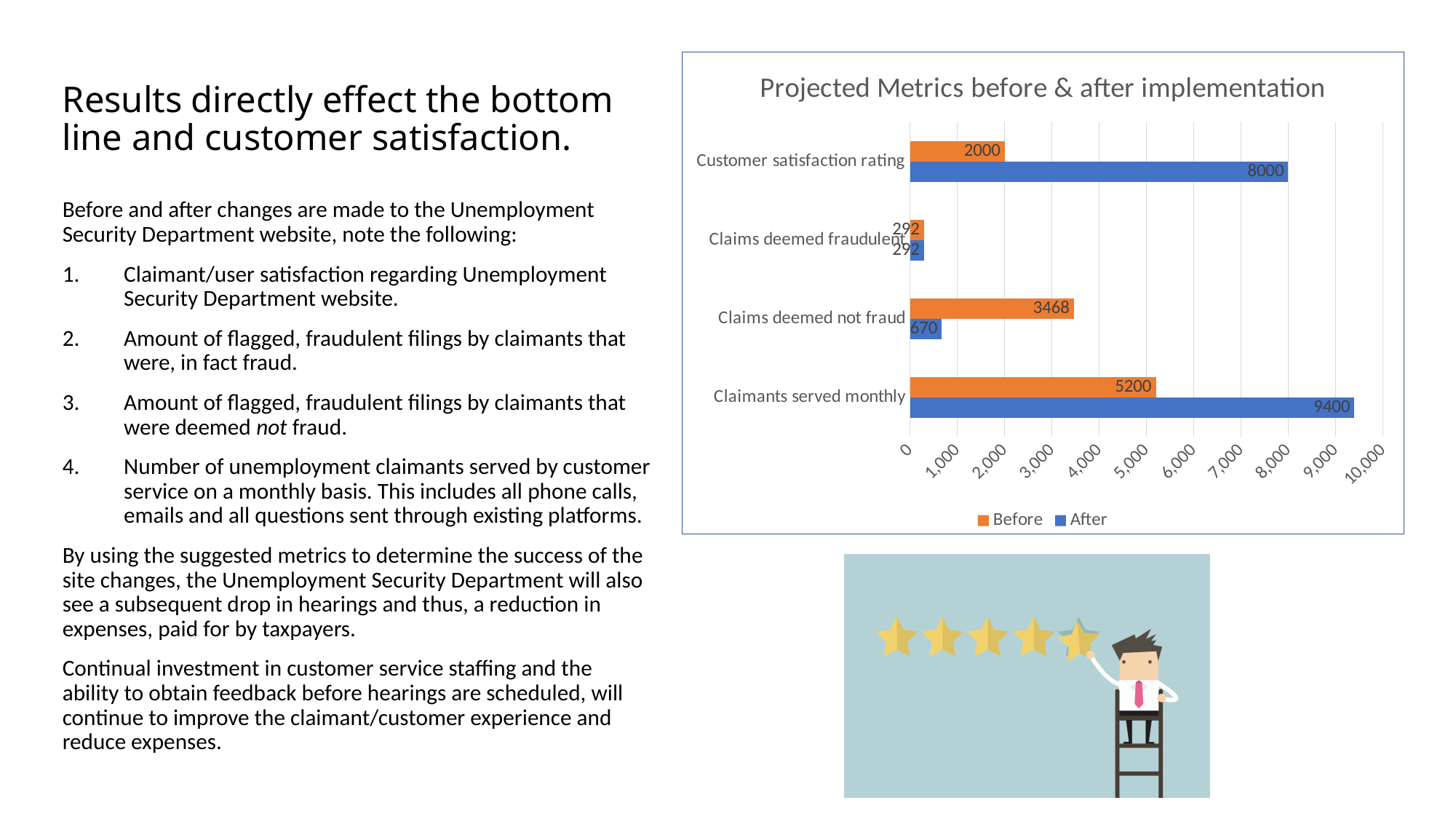
Which category has the highest After value? Claimants served monthly What is the Before value for Customer satisfaction rating? 2000 What is the After value for Claimants served monthly? 9400 What type of chart is shown on the slide? Bar chart Which series is shown in orange? Before Which category has the lowest Before value? Claims deemed fraudulent What is the difference between the After and Before values for Customer satisfaction rating? 6000 How many categories are shown on the chart? 4 How many series does the chart legend list? 2 What is the title of the chart? Projected Metrics before & after implementation What is the After value for Claims deemed not fraud? 670 For Claims deemed not fraud, which is larger, the Before value or the After value? Before